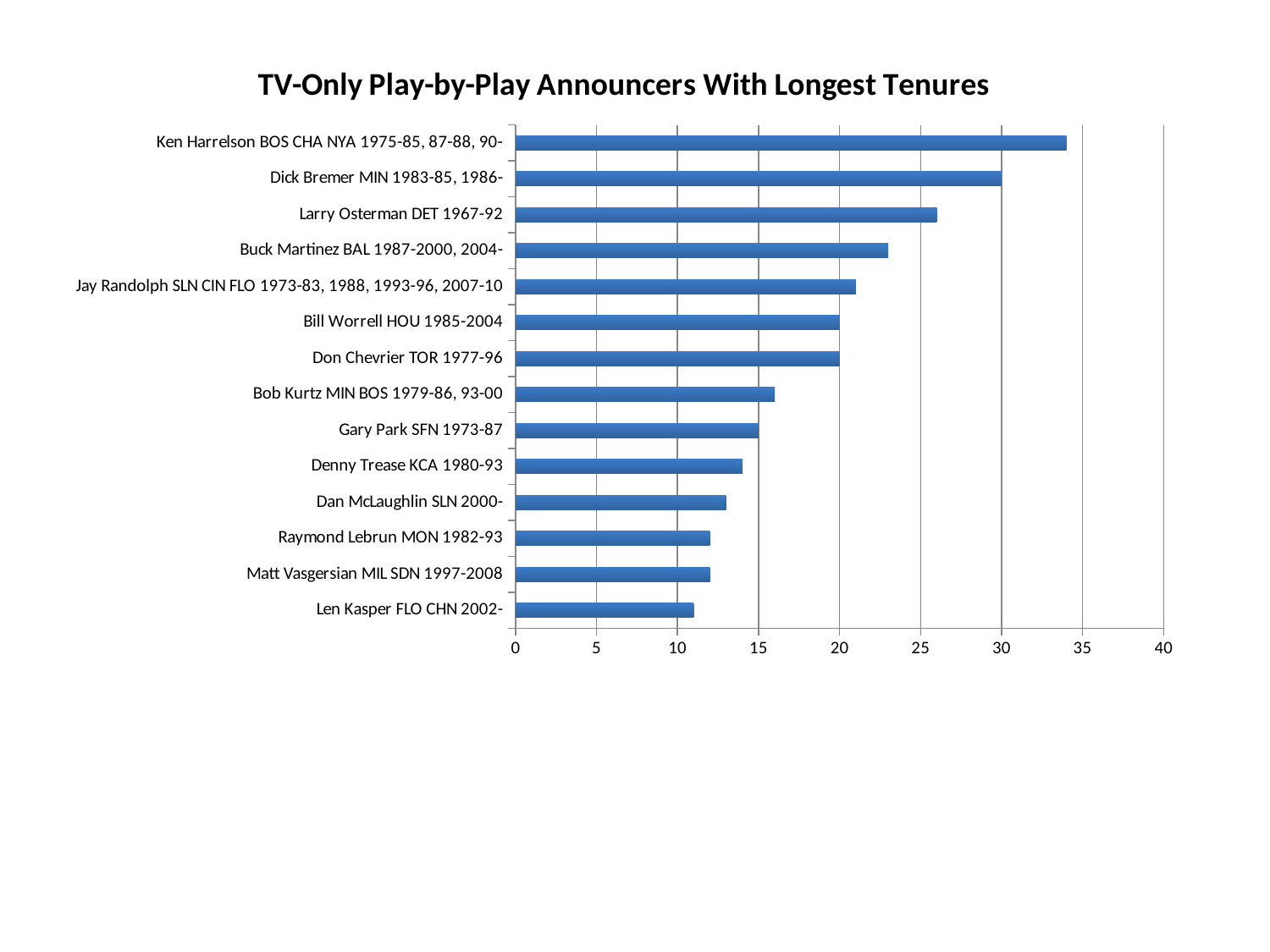
Is the value for Len Kasper greater or less than 10? greater Is the value for Larry Osterman greater or less than 25? greater How many announcers are listed in the chart? 14 Which has the larger value, Larry Osterman or Buck Martinez? Larry Osterman Is the value for Buck Martinez greater or less than 25? less Which announcer has the shortest bar in the chart? Len Kasper FLO CHN 2002- What is the title of the chart? TV-Only Play-by-Play Announcers With Longest Tenures What type of chart is shown on the slide? bar chart Which announcer has the longest bar in the chart? Ken Harrelson BOS CHA NYA 1975-85, 87-88, 90-